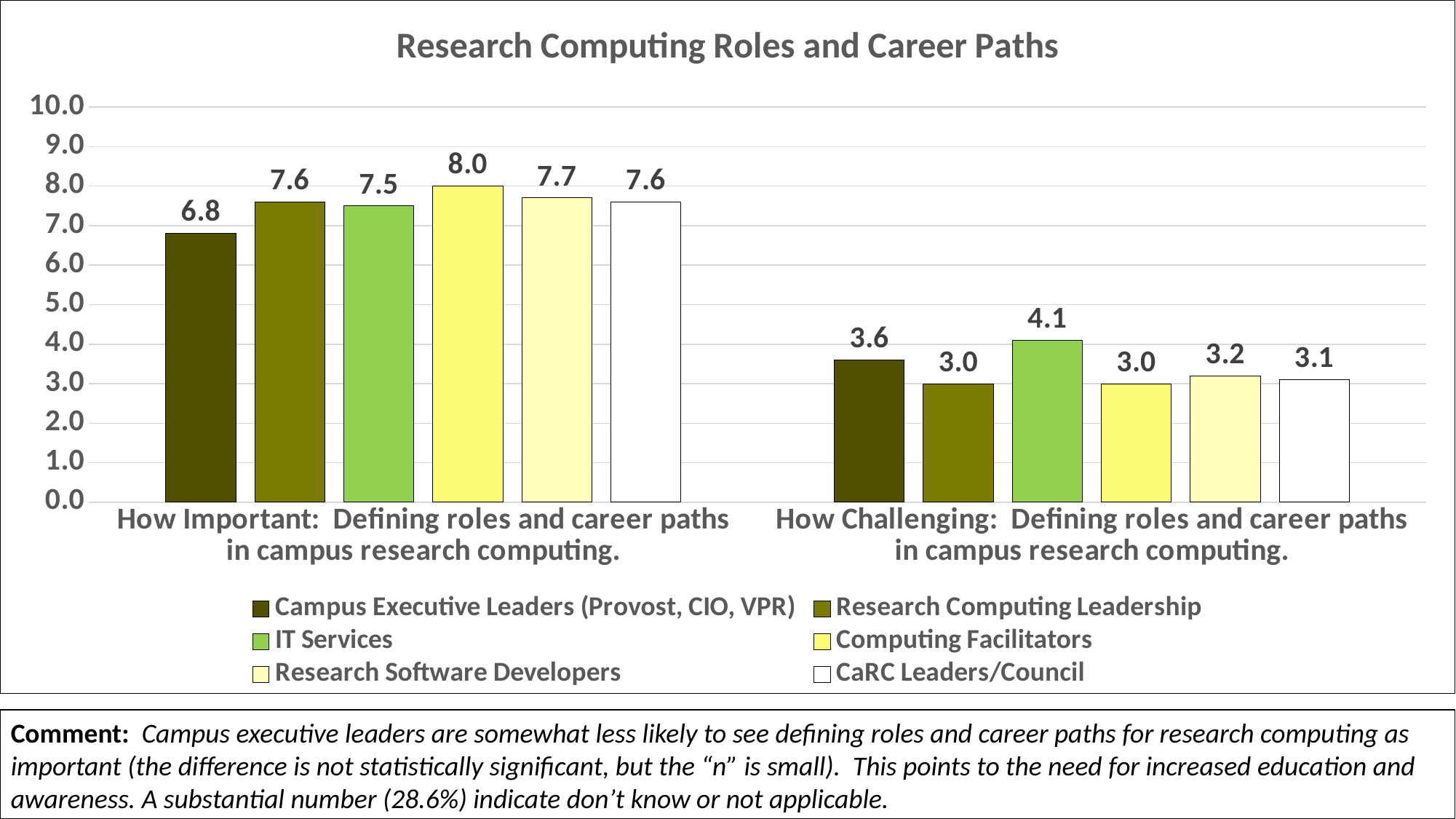
How many series does the legend list? 6 Which is larger in the 'How Challenging' group: Campus Executive Leaders or Research Computing Leadership? Campus Executive Leaders Which series has the highest value in the 'How Important' group? Computing Facilitators Which series has the highest value in the 'How Challenging' group? IT Services Which series has the lowest value in the 'How Important' group? Campus Executive Leaders (Provost, CIO, VPR) What is the value for IT Services in the 'How Challenging' group? 4.1 What is the value for Computing Facilitators in the 'How Important' group? 8.0 How many category groups are shown on the x axis? 2 What kind of chart is shown on the slide? Bar chart What is the title of the chart? Research Computing Roles and Career Paths What is the difference between the Computing Facilitators value and the Campus Executive Leaders value in the 'How Important' group? 1.2 What is the value for Campus Executive Leaders (Provost, CIO, VPR) in the 'How Important' group? 6.8